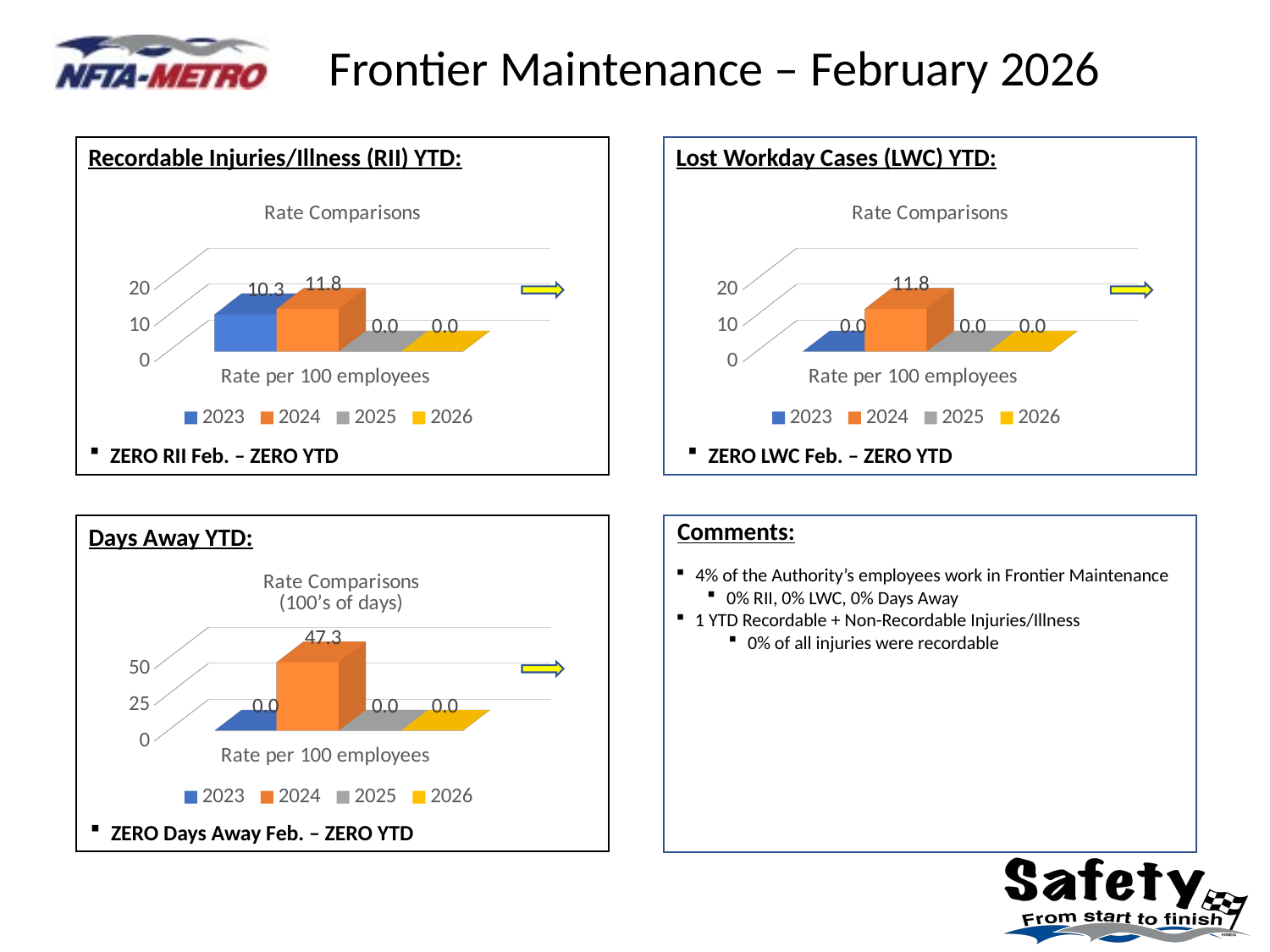
In the Days Away YTD chart, what is the value for 2026? 0.0 How many series does the legend of the Days Away YTD chart list? 4 In the Lost Workday Cases (LWC) YTD chart, what is the value for 2023? 0.0 In the Lost Workday Cases (LWC) YTD chart, what is the value for 2024? 11.8 In the Recordable Injuries/Illness (RII) YTD chart, what is the difference between the 2024 and 2023 values? 1.5 In the Recordable Injuries/Illness (RII) YTD chart, what is the value for 2024? 11.8 In the Recordable Injuries/Illness (RII) YTD chart, which year has the highest value? 2024 In the Days Away YTD chart, what is the value for 2024? 47.3 In the Days Away YTD chart, which year has the highest value? 2024 In the Lost Workday Cases (LWC) YTD chart, is the value for 2024 greater or less than 10? greater In the Recordable Injuries/Illness (RII) YTD chart, what is the value for 2023? 10.3 What kind of chart is the Recordable Injuries/Illness (RII) YTD chart? Bar chart